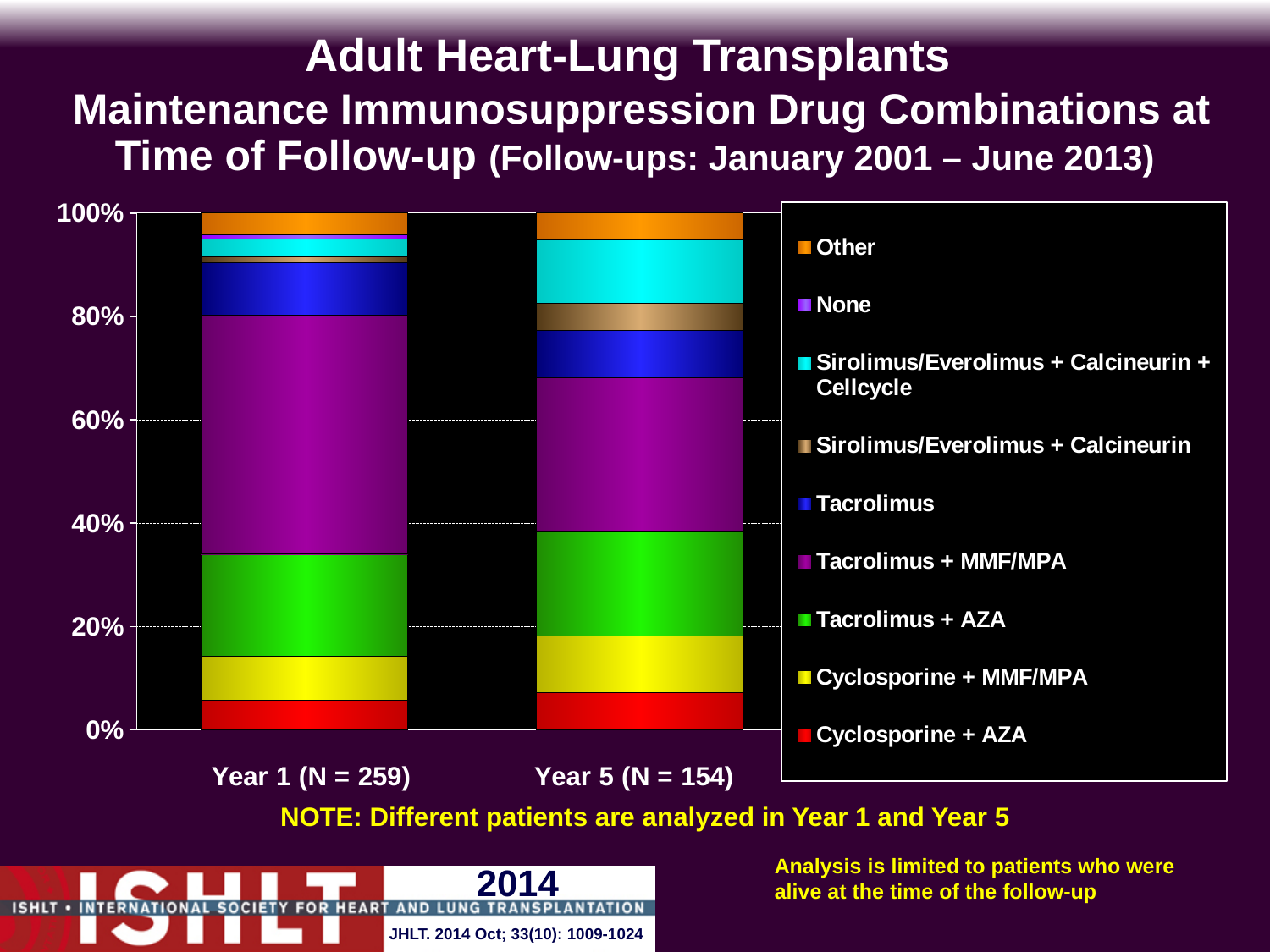
What is the N for the Year 1 bar? 259 What is the N for the Year 5 bar? 154 Which drug combination occupies the largest segment of the Year 1 bar? Tacrolimus + MMF/MPA What percentage does each stacked bar total? 100% Does the share of Tacrolimus + MMF/MPA rise or fall from Year 1 to Year 5? Fall What type of chart is shown on the slide? Stacked bar chart What colour represents Tacrolimus + MMF/MPA in the chart? Purple In the Year 1 bar, is the cumulative percentage at the top of the Tacrolimus + AZA segment greater or less than 40%? less How many bars (follow-up time points) are plotted in the chart? 2 Is the share of Sirolimus/Everolimus + Calcineurin + Cellcycle larger in Year 1 or in Year 5? Year 5 How many drug combination categories does the legend list? 9 Is the share of Tacrolimus + MMF/MPA larger in Year 1 or in Year 5? Year 1